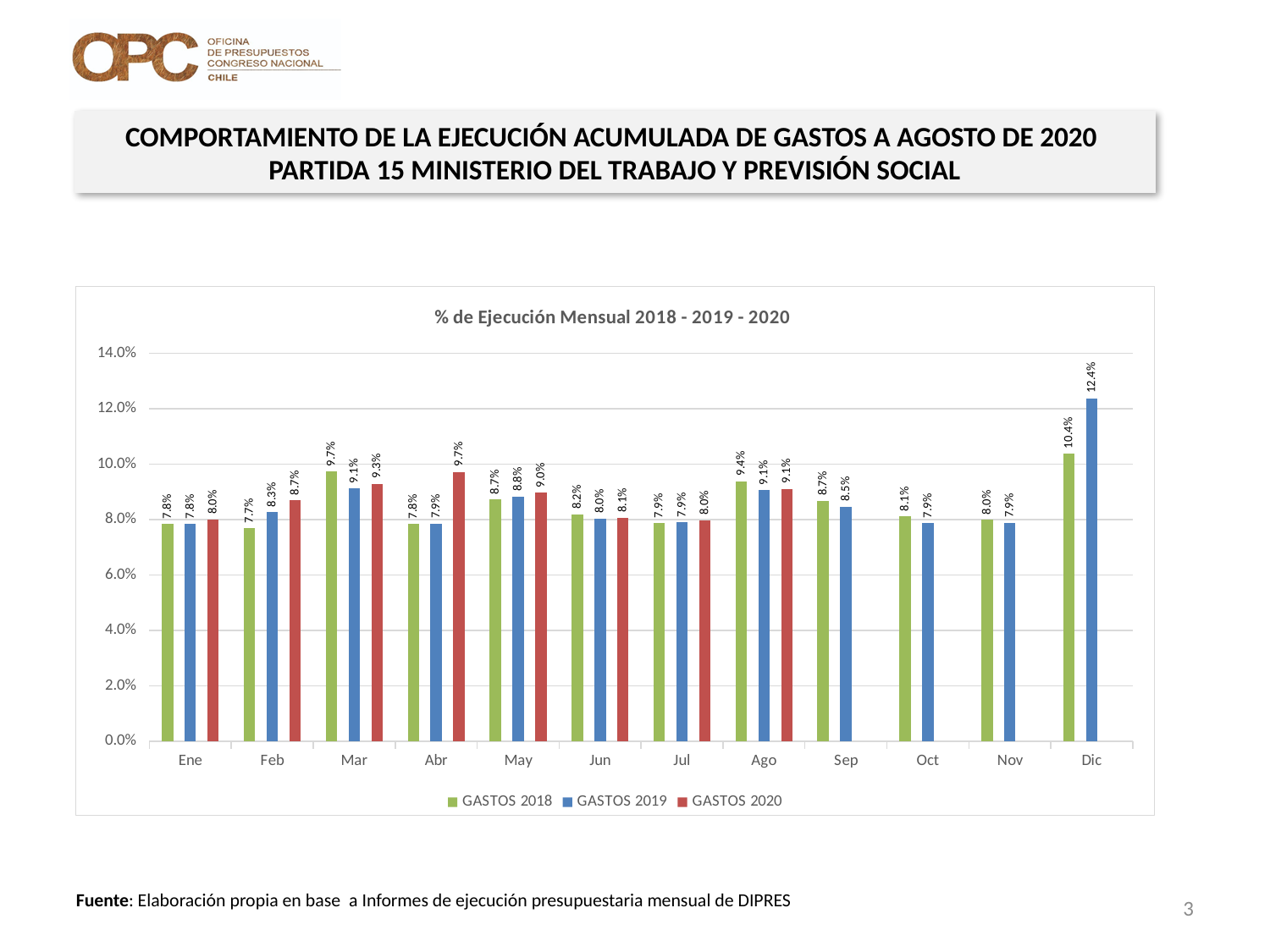
What is the difference between GASTOS 2019 and GASTOS 2018 in Dic? 2.0% What is the title of the chart? % de Ejecución Mensual 2018 - 2019 - 2020 Is the value for GASTOS 2019 in Dic greater or less than 12.0%? greater Which month has the highest value for GASTOS 2019? Dic What is the value for GASTOS 2019 in Feb? 8.3% What is the value for GASTOS 2020 in Abr? 9.7% Which is larger in Mar: GASTOS 2018 or GASTOS 2019? GASTOS 2018 What kind of chart is shown? Bar chart How many series does the legend list? 3 Which month has the lowest value for GASTOS 2018? Feb What is the value for GASTOS 2018 in Dic? 10.4% How many months are shown on the x axis? 12